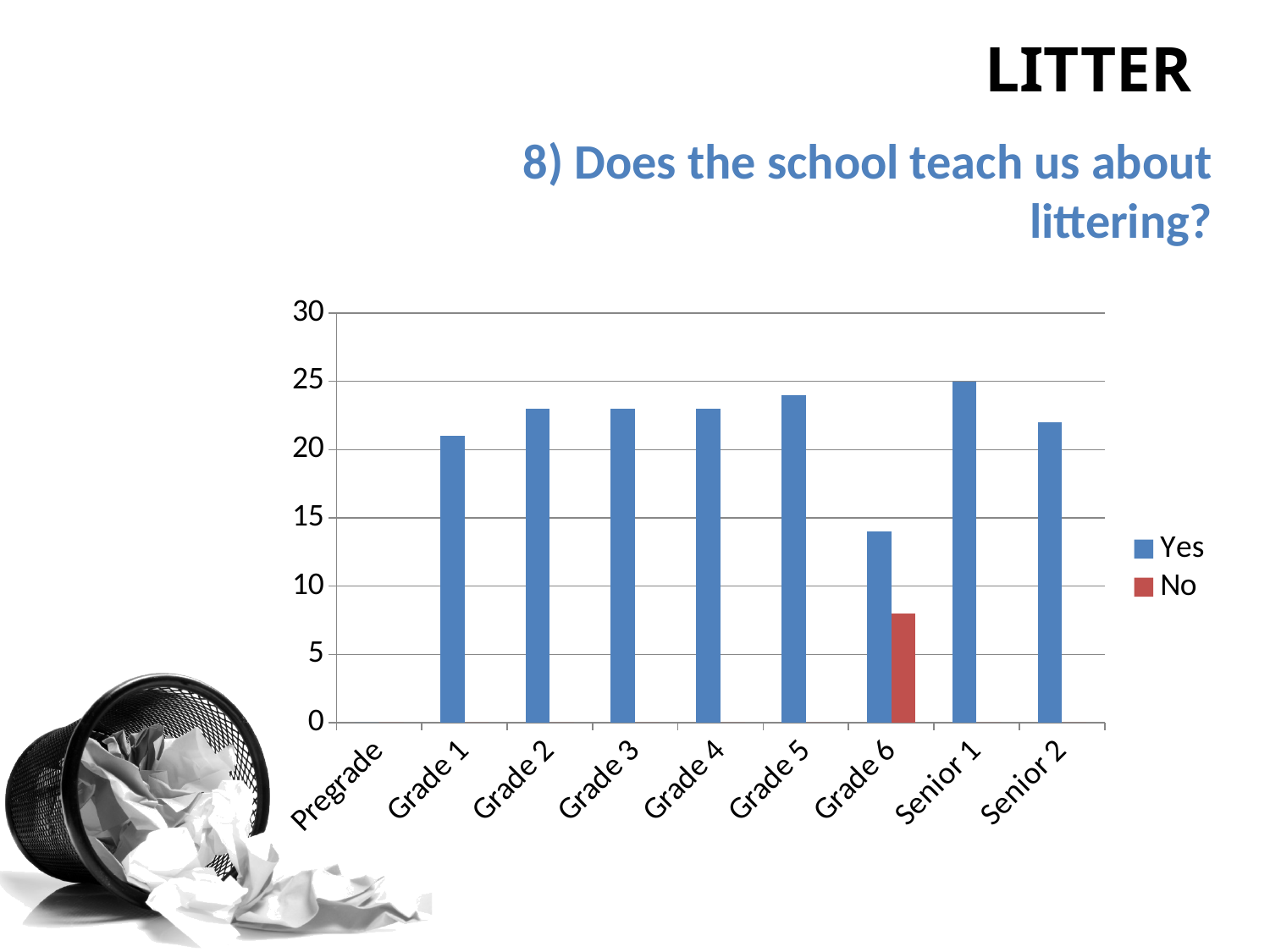
Which category has the highest Yes bar? Senior 1 Is the Yes value for Senior 2 greater or less than 20? greater How many series does the legend list? 2 Which is larger, the Yes value for Grade 1 or the Yes value for Grade 5? Grade 5 Is the No value for Grade 6 greater or less than 10? less What kind of chart is shown on the slide? bar chart Is the Yes value for Grade 6 greater or less than 15? less How many categories are shown on the x axis? 9 Which category is the only one with a visible No bar? Grade 6 Among the categories with a visible Yes bar, which has the lowest Yes value? Grade 6 For Grade 6, which is larger, the Yes value or the No value? Yes